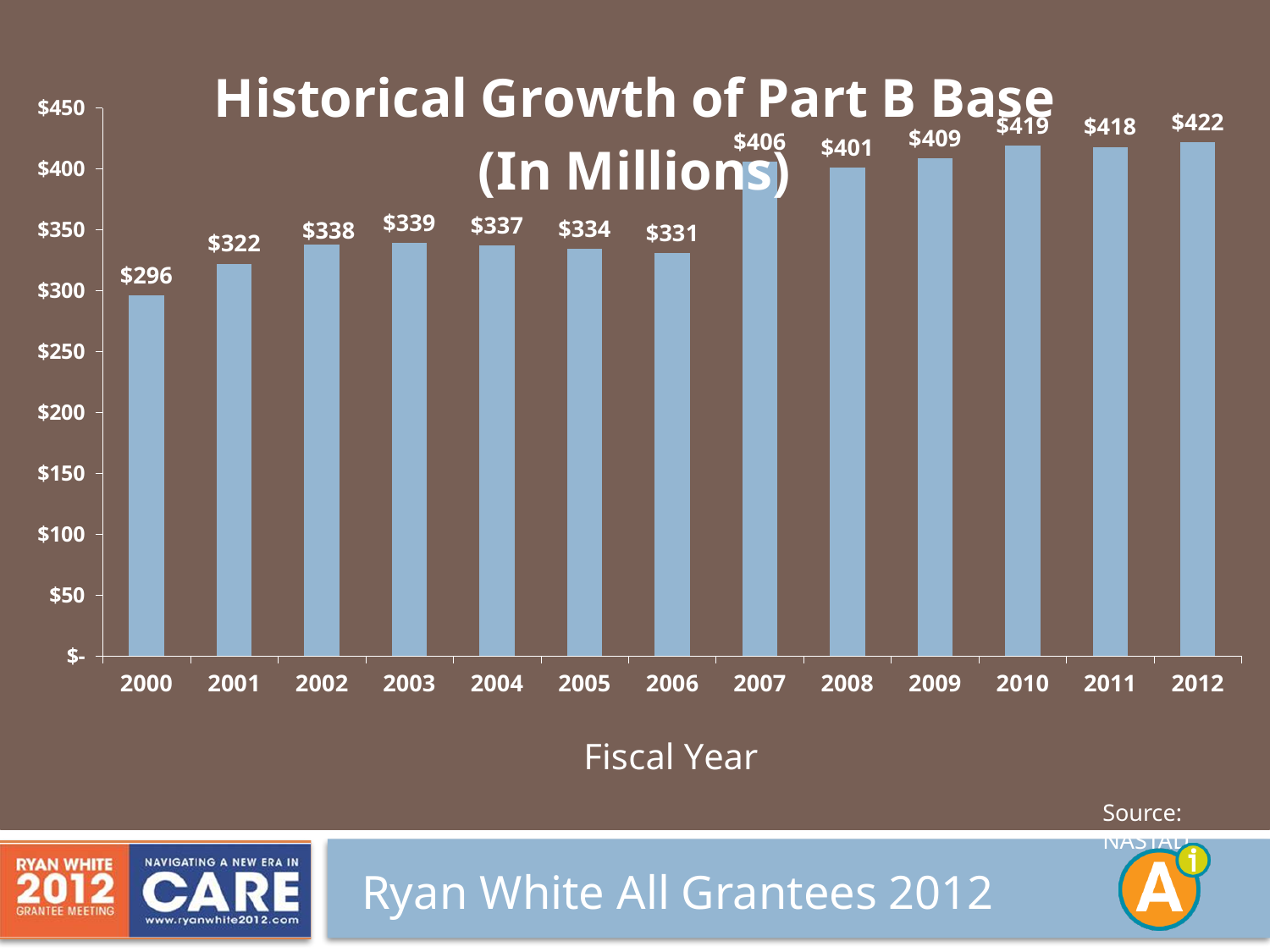
How many fiscal years are shown on the chart? 13 Which fiscal year has a larger Part B Base value, 2003 or 2006? 2003 Which fiscal year has the lowest Part B Base value? 2000 Is the Part B Base value for 2008 greater or less than $350? greater What is the difference between the Part B Base values for 2007 and 2006? $75 Which fiscal year has the highest Part B Base value? 2012 What is the Part B Base value for fiscal year 2012? $422 What is the difference between the Part B Base values for 2012 and 2000? $126 What is the Part B Base value for fiscal year 2000? $296 What is the Part B Base value for fiscal year 2007? $406 What is the title of the chart? Historical Growth of Part B Base (In Millions) What type of chart is shown on the slide? Bar chart